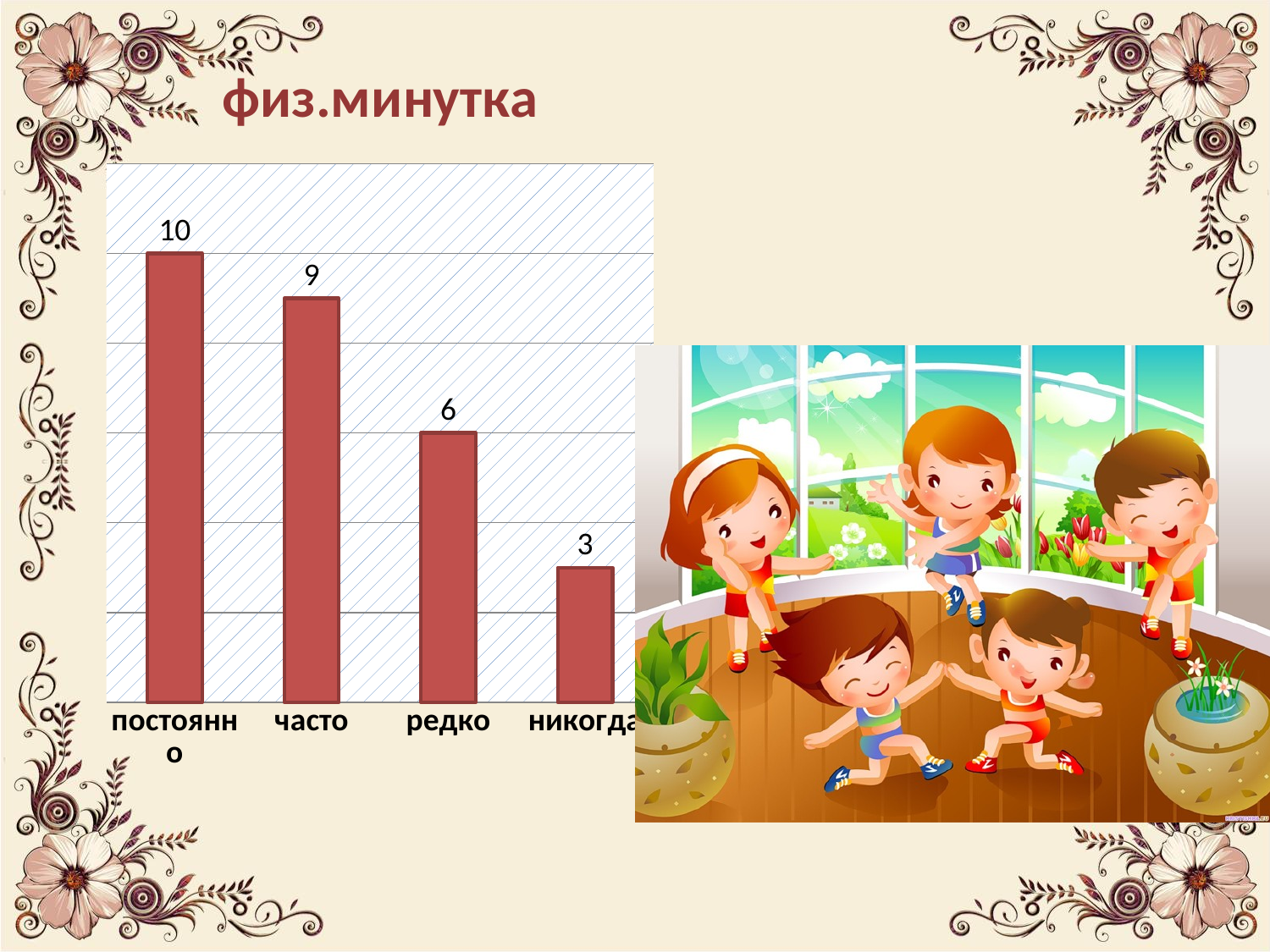
Which category has the highest value? постоянно What is the value for "редко"? 6 What is the difference between the values for "постоянно" and "никогда"? 7 What is the value for "часто"? 9 What kind of chart is shown on the slide? bar chart What is the difference between the values for "часто" and "редко"? 3 What is the value for "постоянно"? 10 Which is larger, the value for "редко" or the value for "никогда"? редко Do the values rise or fall from left to right along the x axis? fall Which category has the lowest value? никогда What is the value for "никогда"? 3 How many categories are shown in the chart? 4